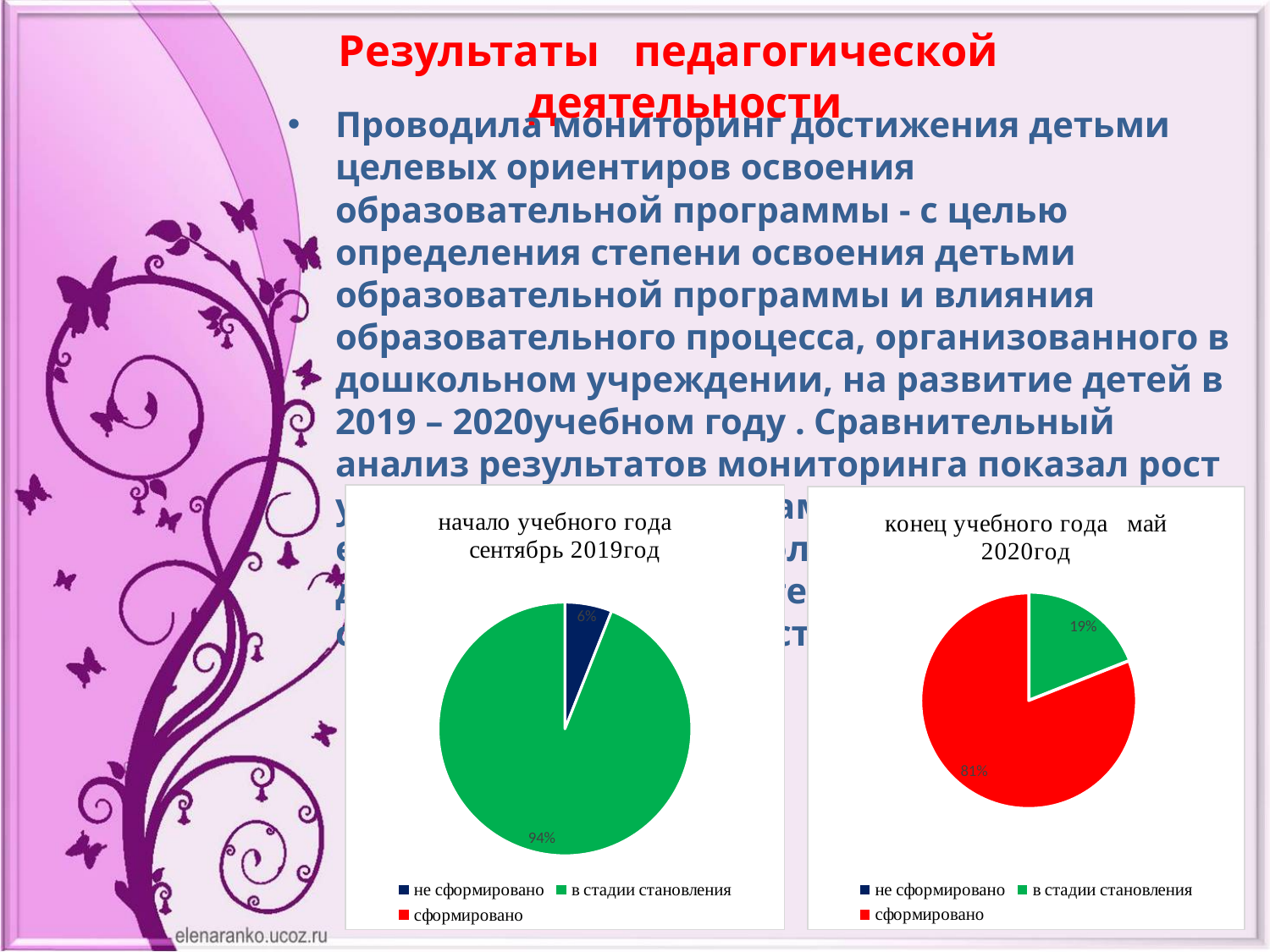
In the left chart (начало учебного года сентябрь 2019год), what share is labelled for the 'не сформировано' slice? 6% How many entries does the legend of the left chart (начало учебного года сентябрь 2019год) list? 3 In the left chart (начало учебного года сентябрь 2019год), what is the difference between the 'в стадии становления' and 'не сформировано' shares? 88% In the right chart (конец учебного года май 2020год), which category has the largest slice? сформировано What type of chart is used on this slide? Pie chart In the right chart (конец учебного года май 2020год), what is the difference between the 'сформировано' and 'в стадии становления' shares? 62% In the right chart (конец учебного года май 2020год), which category has the smallest visible slice? в стадии становления In the right chart (конец учебного года май 2020год), what share is labelled for the 'в стадии становления' slice? 19% In the right chart (конец учебного года май 2020год), what share is labelled for the 'сформировано' slice? 81% In the left chart (начало учебного года сентябрь 2019год), which category has the largest slice? в стадии становления In the right chart (конец учебного года май 2020год), what colour is the 'сформировано' slice? Red In the left chart (начало учебного года сентябрь 2019год), what share is labelled for the 'в стадии становления' slice? 94%